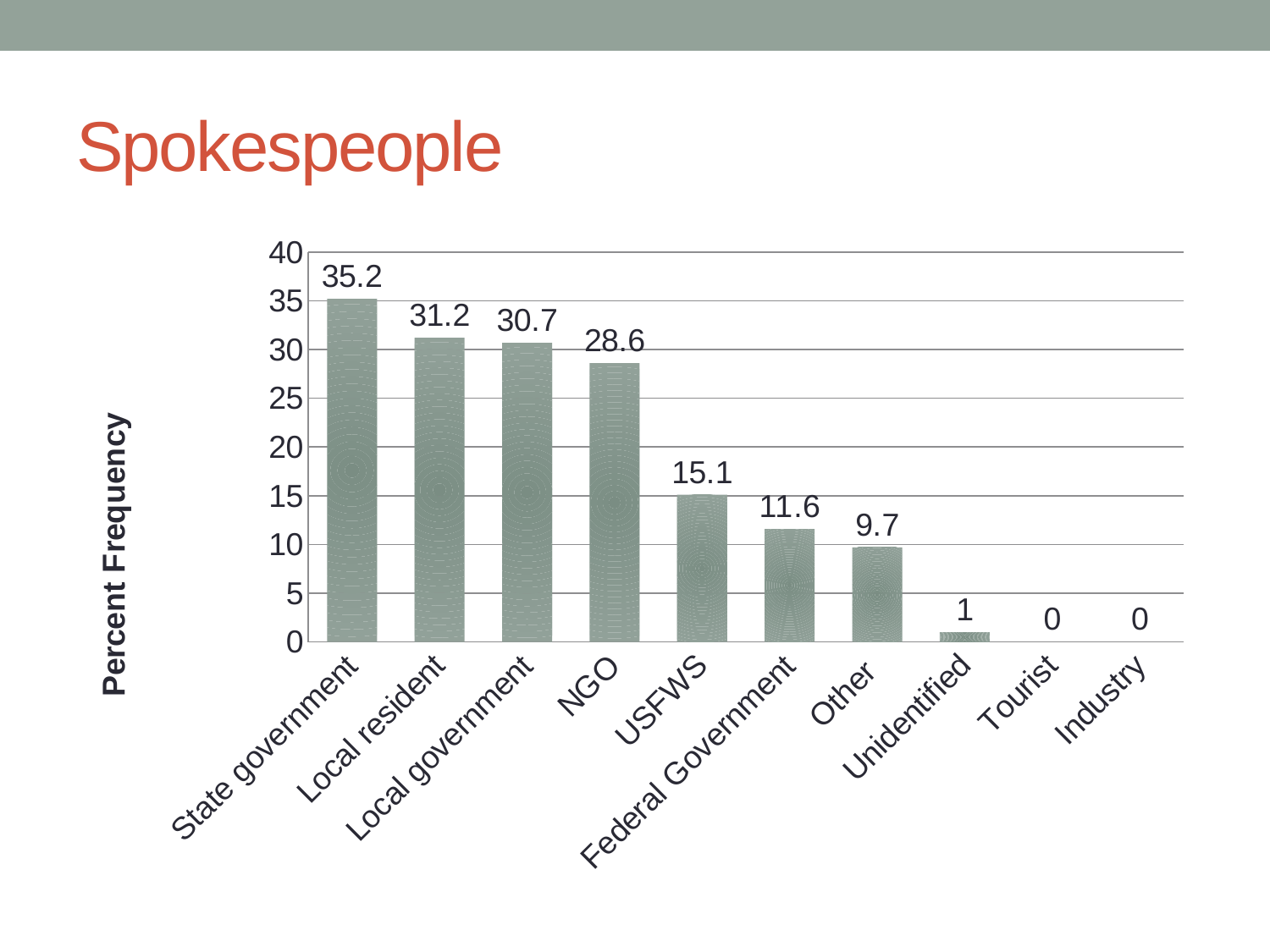
Do the values rise or fall from left to right along the x axis? Fall What is the percent frequency for USFWS? 15.1 What is the percent frequency for Federal Government? 11.6 What is the percent frequency for State government? 35.2 How many categories are shown on the x axis? 10 Which category has the highest percent frequency? State government What is the difference in percent frequency between Local resident and Local government? 0.5 What is the label of the y axis? Percent Frequency What kind of chart is shown on the slide? Bar chart What is the difference in percent frequency between NGO and Other? 18.9 Is the value for Other greater or less than 10? less Which has a higher percent frequency, NGO or USFWS? NGO